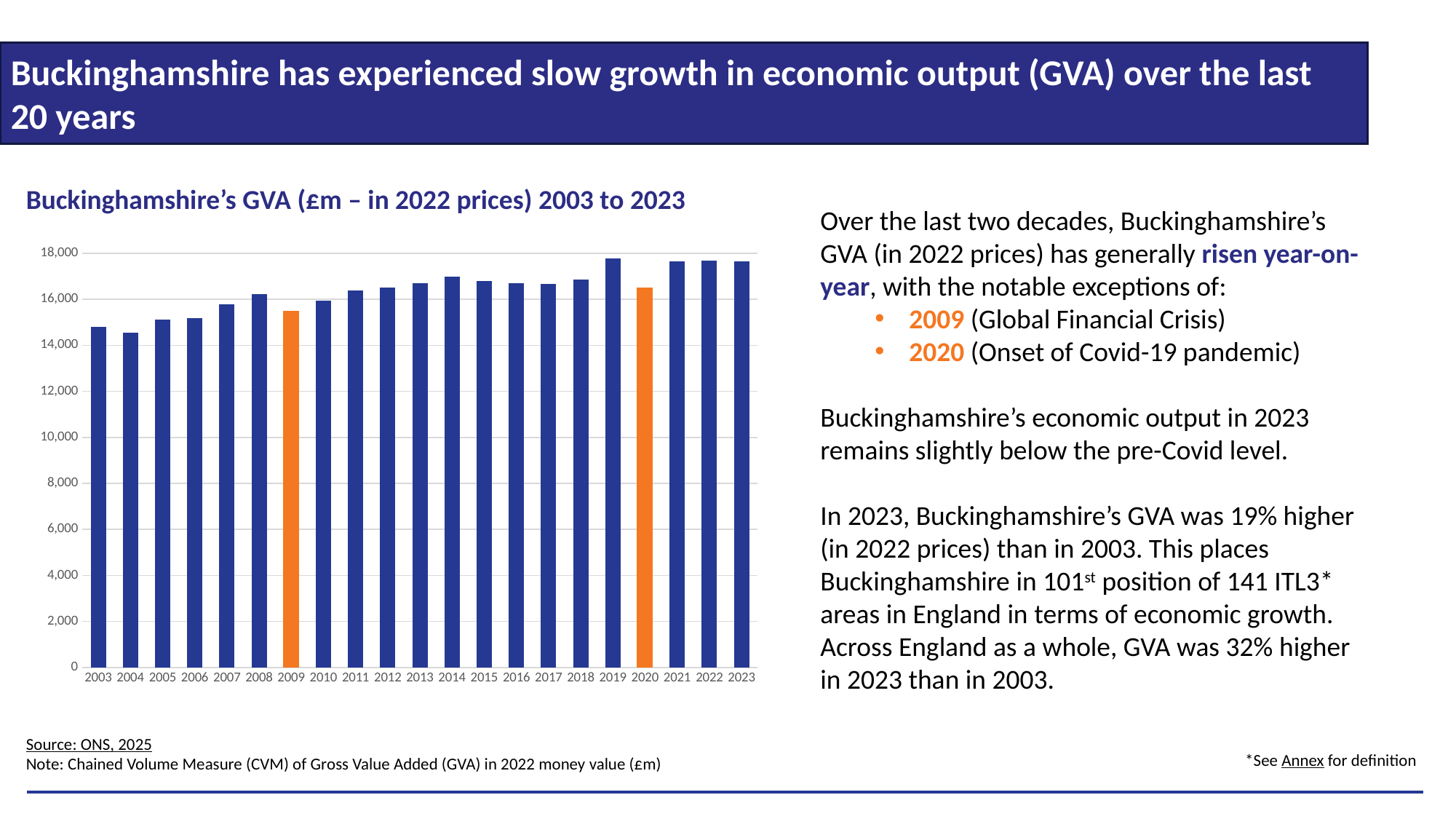
How many years are plotted on the chart? 21 Is the GVA value for 2003 greater or less than 14,000? greater What kind of chart is shown on the slide? Bar chart Which year has the highest GVA on the chart? 2019 Is the GVA value for 2020 greater or less than 16,000? greater Overall, does Buckinghamshire's GVA rise or fall from 2003 to 2023? Rise Which two years are highlighted in orange on the chart? 2009 and 2020 Which year has the lowest GVA on the chart? 2004 Is the GVA value for 2009 greater or less than 16,000? less Which year has the larger GVA, 2009 or 2020? 2020 Which year has the larger GVA, 2019 or 2023? 2019